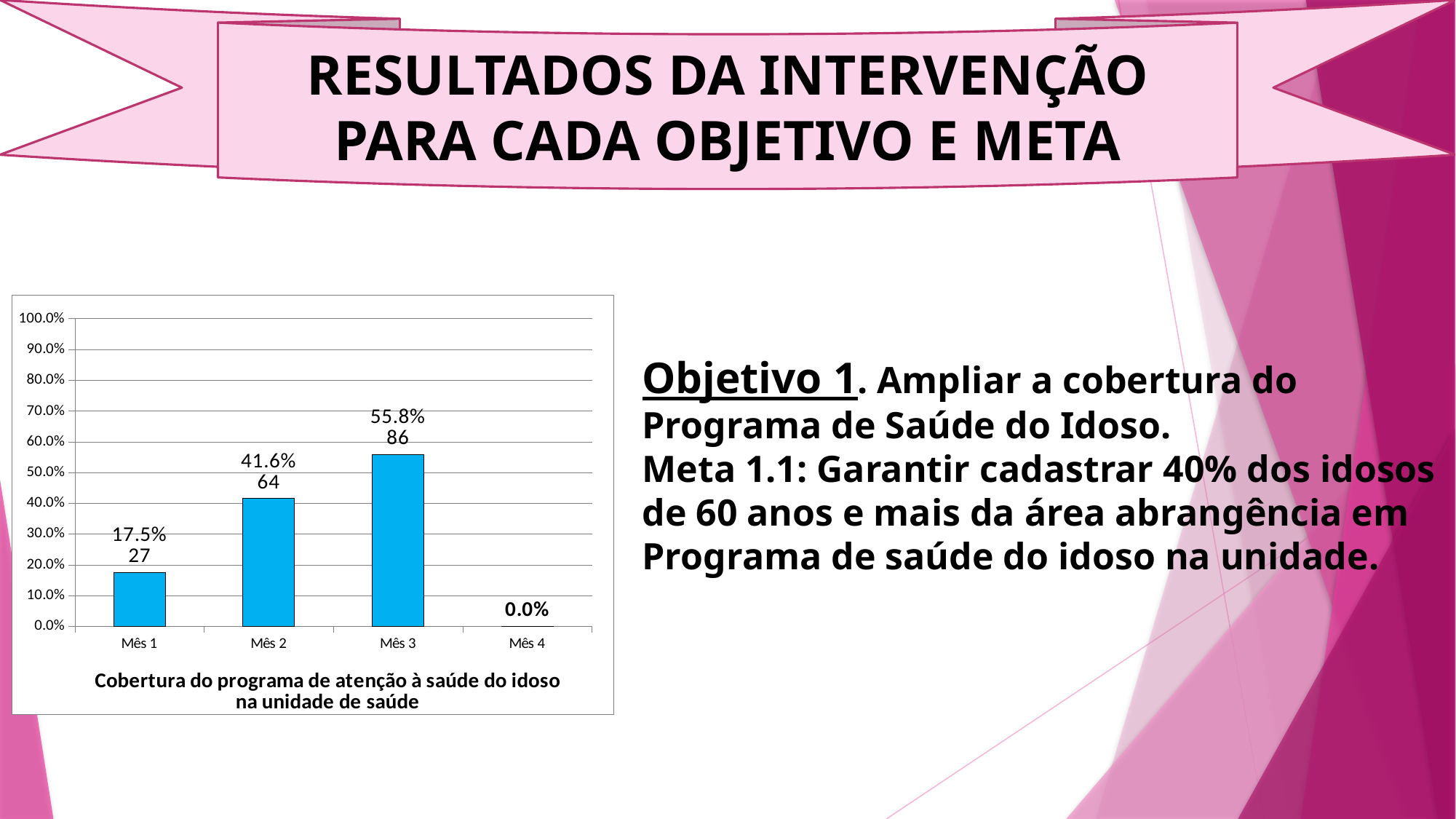
What is the percentage value shown for Mês 2? 41.6% Which month has the highest coverage percentage? Mês 3 What count is printed above the bar for Mês 1? 27 Which is larger, the value for Mês 2 or the value for Mês 1? Mês 2 What is the percentage value shown for Mês 3? 55.8% What kind of chart is shown on the slide? Bar chart What is the difference in percentage points between Mês 3 and Mês 2? 14.2 What is the title printed below the chart? Cobertura do programa de atenção à saúde do idoso na unidade de saúde How many months are shown on the x axis of the chart? 4 Which month has the lowest coverage percentage? Mês 4 What count is printed above the bar for Mês 3? 86 What is the percentage value shown for Mês 1? 17.5%